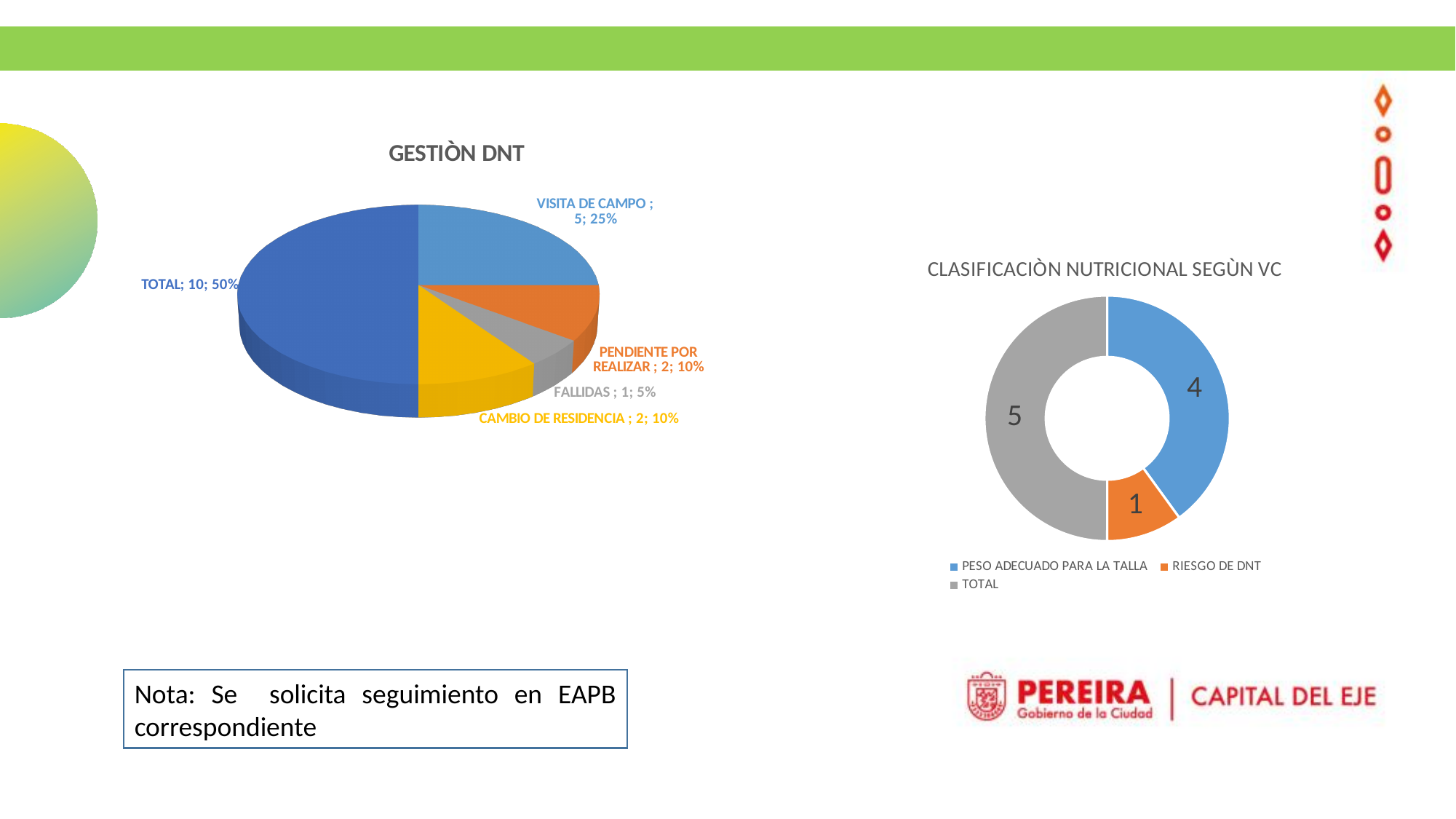
In the GESTIÒN DNT chart, what is the difference between the values for VISITA DE CAMPO and PENDIENTE POR REALIZAR? 3 How many slices does the GESTIÒN DNT pie chart have? 5 In the CLASIFICACIÒN NUTRICIONAL SEGÙN VC chart, what value is shown for PESO ADECUADO PARA LA TALLA? 4 In the CLASIFICACIÒN NUTRICIONAL SEGÙN VC chart, which category has the largest value? TOTAL How many entries does the legend of the CLASIFICACIÒN NUTRICIONAL SEGÙN VC chart list? 3 In the GESTIÒN DNT chart, which category has the smallest slice? FALLIDAS In the CLASIFICACIÒN NUTRICIONAL SEGÙN VC chart, what value is shown for RIESGO DE DNT? 1 In the GESTIÒN DNT chart, what percentage share does the TOTAL slice have? 50% In the GESTIÒN DNT chart, what value is shown for VISITA DE CAMPO? 5 What type of chart is the GESTIÒN DNT chart? Pie chart In the GESTIÒN DNT chart, which is larger, the value for CAMBIO DE RESIDENCIA or the value for FALLIDAS? CAMBIO DE RESIDENCIA In the GESTIÒN DNT chart, what percentage is shown for FALLIDAS? 5%